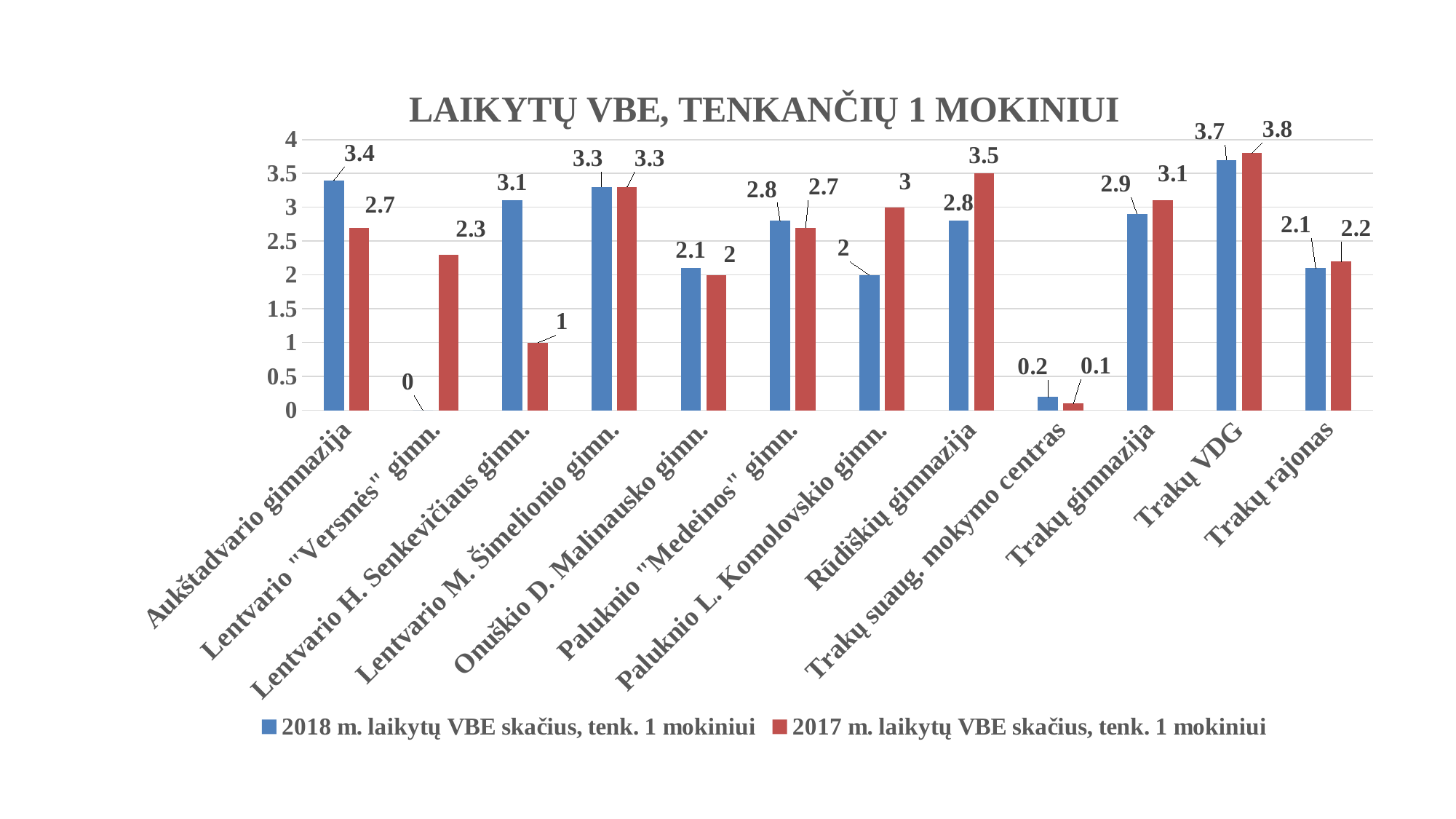
How many series does the legend list? 2 Which is larger for Lentvario "Versmės" gimn.: the 2018 value or the 2017 value? 2017 value What is the 2017 value for Lentvario H. Senkevičiaus gimn.? 1 What is the title of the chart? LAIKYTŲ VBE, TENKANČIŲ 1 MOKINIUI What is the 2017 value (2017 m. laikytų VBE skaičius, tenk. 1 mokiniui) for Rūdiškių gimnazija? 3.5 What kind of chart is shown on the slide? Bar chart What is the 2018 value (2018 m. laikytų VBE skaičius, tenk. 1 mokiniui) for Aukštadvario gimnazija? 3.4 What is the difference between the 2018 and 2017 values for Paluknio L. Komolovskio gimn.? 1 How many categories are shown on the x axis? 12 Is the 2018 value for Trakų gimnazija greater or less than 2.5? greater Which category has the highest 2018 value? Trakų VDG Which category has the lowest 2017 value? Trakų suaug. mokymo centras